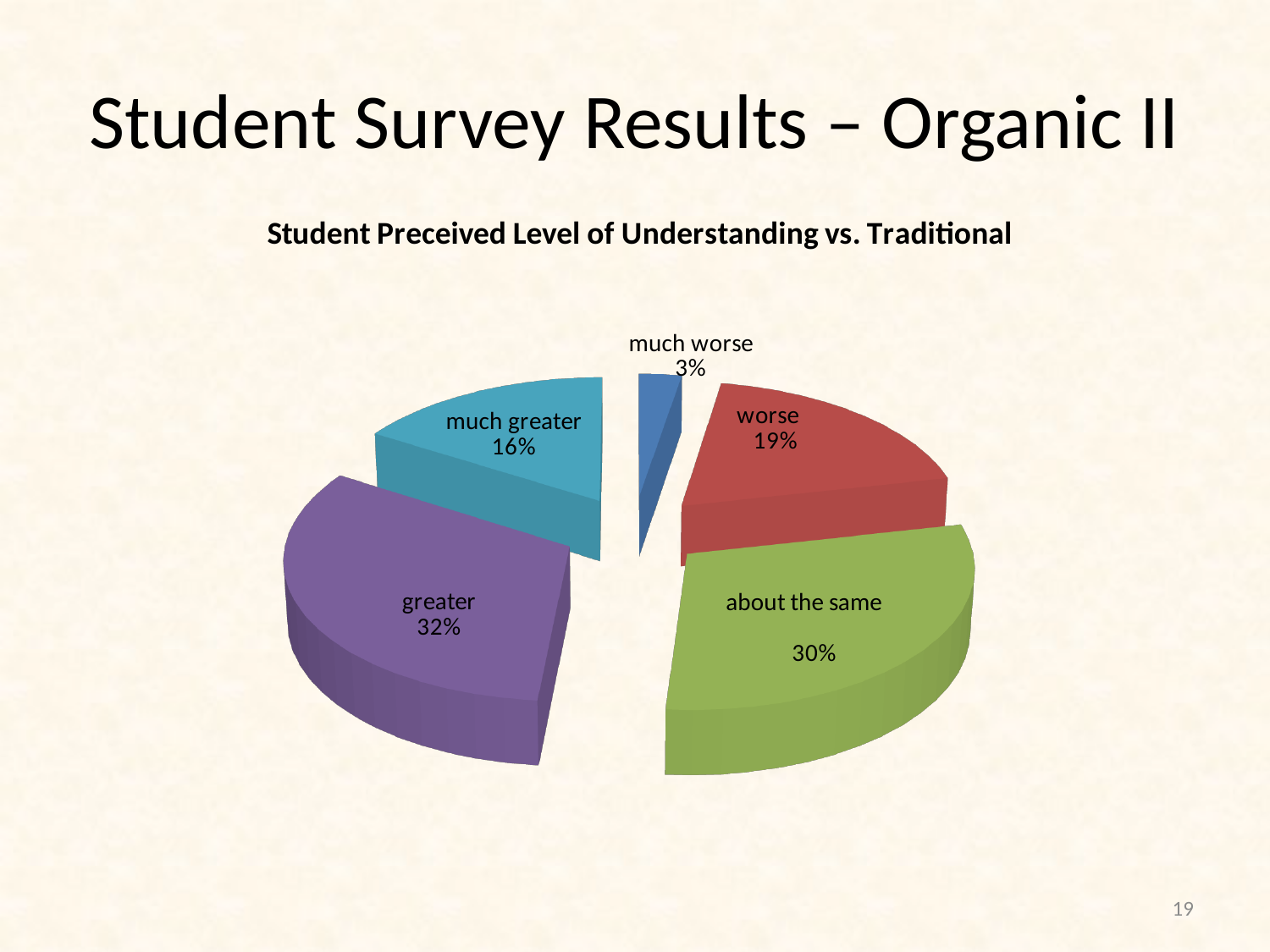
What share of the pie is labelled "much greater"? 16% What is the difference in percentage points between the "worse" slice and the "much worse" slice? 16 What share of the pie is labelled "much worse"? 3% What is the chart's title? Student Preceived Level of Understanding vs. Traditional Which category has the largest slice of the pie? greater How many slices does the pie chart have? 5 Which category has the smallest slice of the pie? much worse Which slice is larger, "much greater" or "worse"? worse What share of the pie is labelled "worse"? 19% What kind of chart is shown on the slide? pie chart